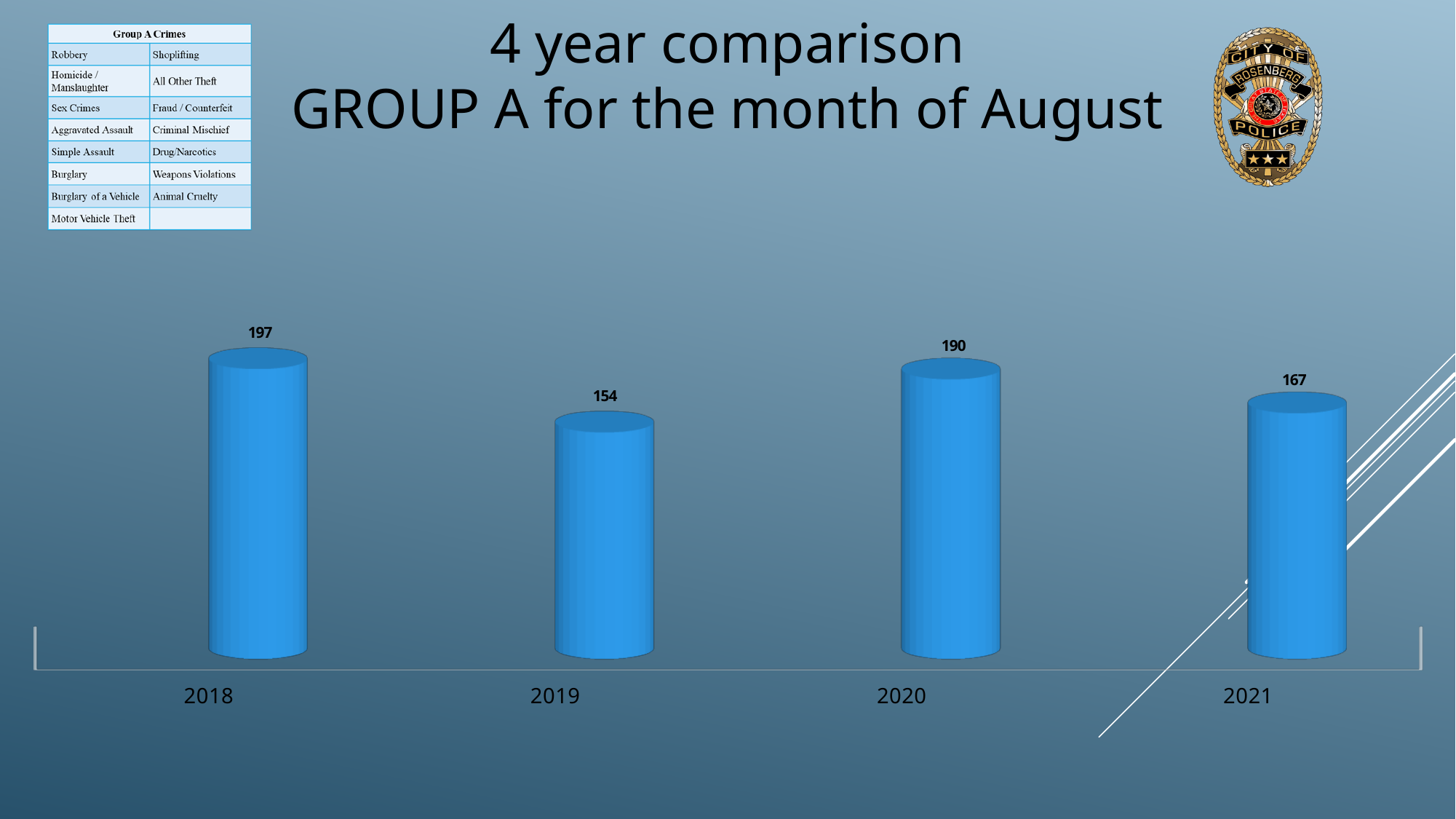
What is the title of the slide? 4 year comparison GROUP A for the month of August Which year has the highest value? 2018 What is the difference between the values for 2020 and 2021? 23 How many years are shown on the chart? 4 Which year has the lowest value? 2019 What is the value for 2019? 154 What is the difference between the values for 2018 and 2019? 43 What kind of chart is shown on the slide? bar chart Which is larger, the value for 2020 or the value for 2021? 2020 What is the value for 2021? 167 What is the value for 2018? 197 What is the value for 2020? 190